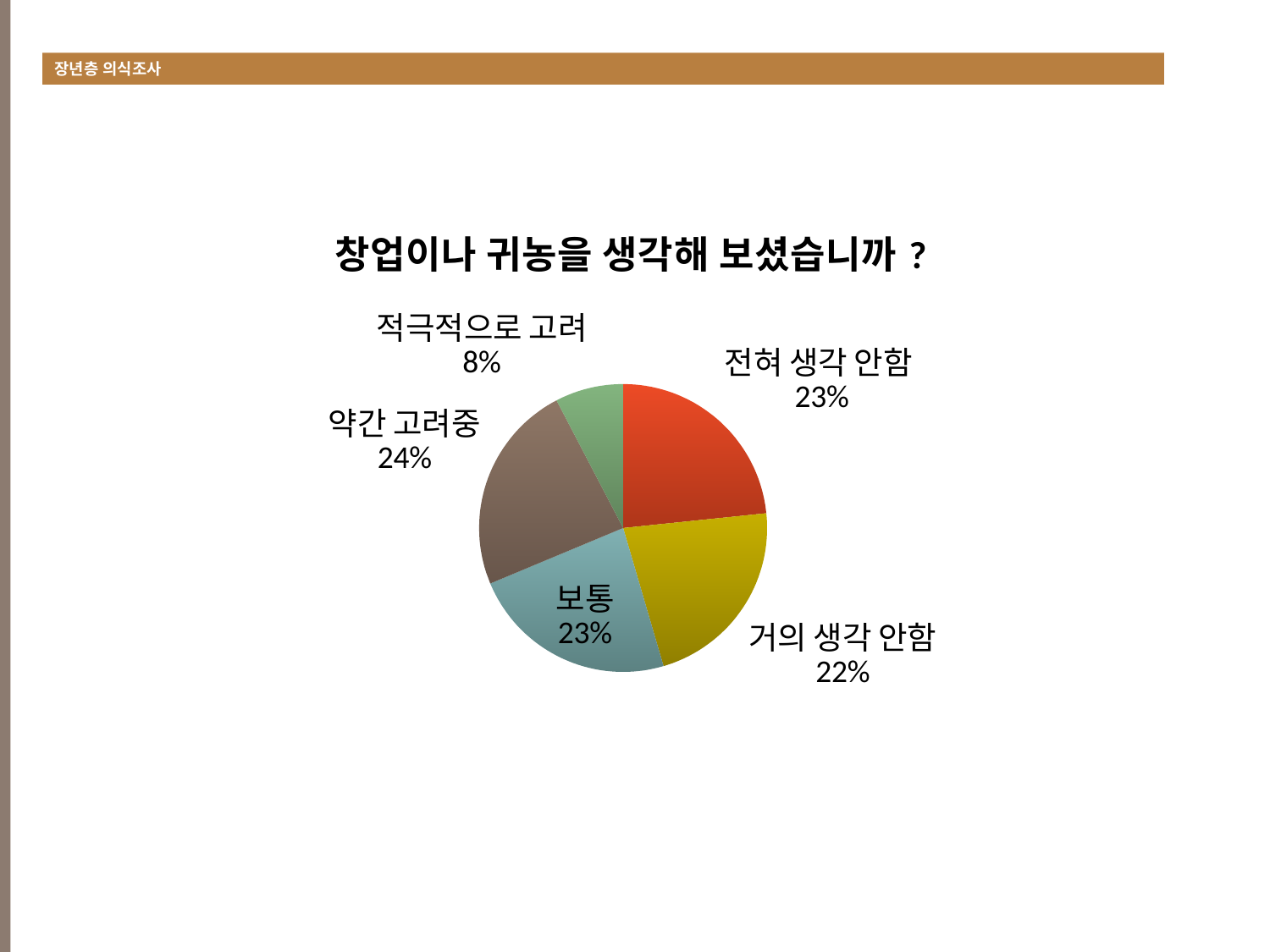
What percentage is shown for 적극적으로 고려? 8% What is the difference between the shares of 약간 고려중 and 적극적으로 고려? 16% How many slices does the pie chart have? 5 What percentage is shown for 전혀 생각 안함? 23% What percentage is shown for 약간 고려중? 24% What percentage is shown for 거의 생각 안함? 22% What percentage is shown for 보통? 23% Which category has the largest share of the pie? 약간 고려중 Which is larger, the share for 거의 생각 안함 or the share for 적극적으로 고려? 거의 생각 안함 What is the title of the chart? 창업이나 귀농을 생각해 보셨습니까 ? Which category has the smallest share of the pie? 적극적으로 고려 What kind of chart is shown on the slide? pie chart